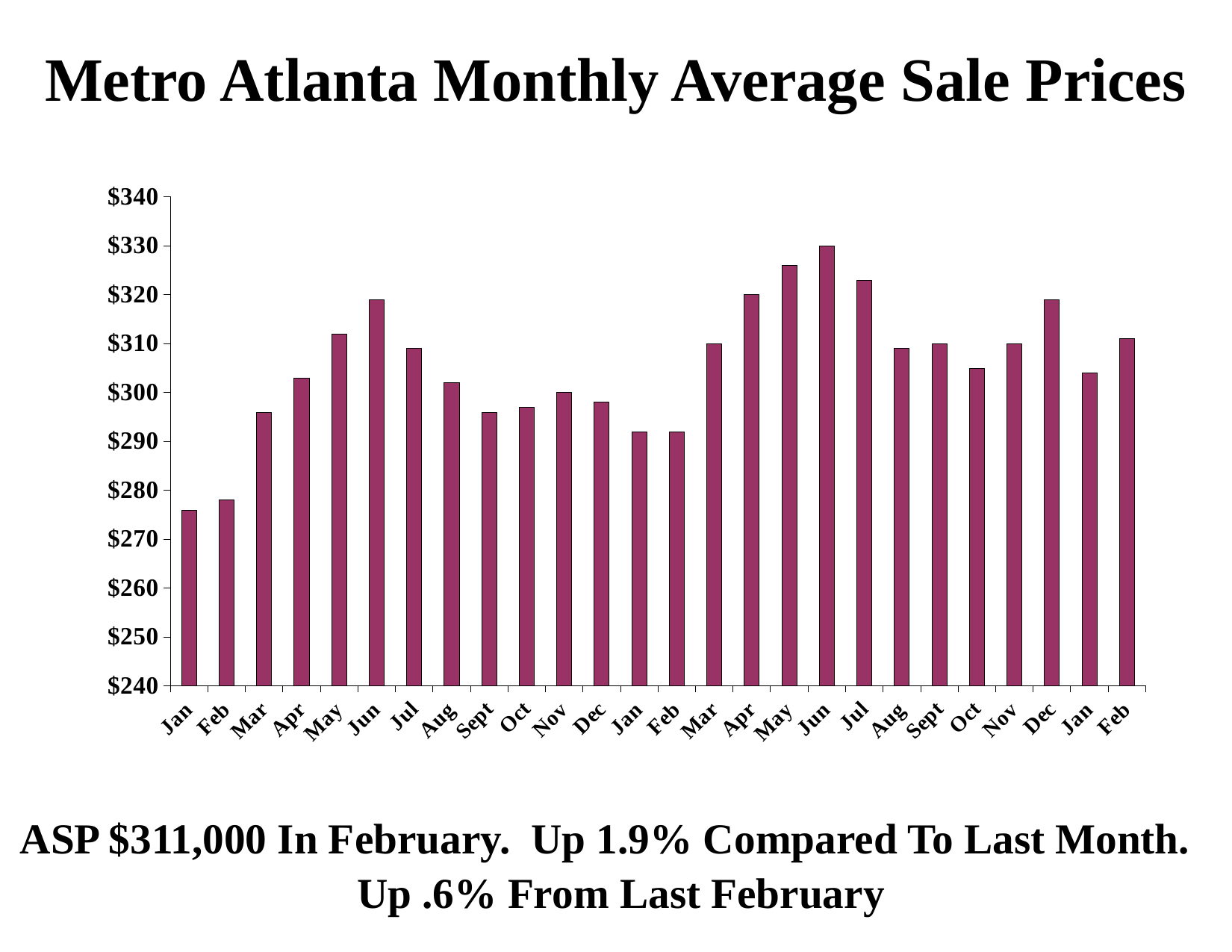
Is the value for the second Jan bar greater or less than $300? less Is the value for the first Jan bar greater or less than $280? less Is the value for the first Jun bar greater or less than $310? greater Do the values rise or fall from the first Jan bar to the first Jun bar? rise What is the title of the chart? Metro Atlanta Monthly Average Sale Prices Which is larger, the first Jun bar or the second Jun bar? the second Jun bar What kind of chart is shown on the slide? bar chart How many bars are plotted in the chart? 26 Which is larger, the first Mar bar or the second Mar bar? the second Mar bar Which month has the highest bar in the chart? the second Jun